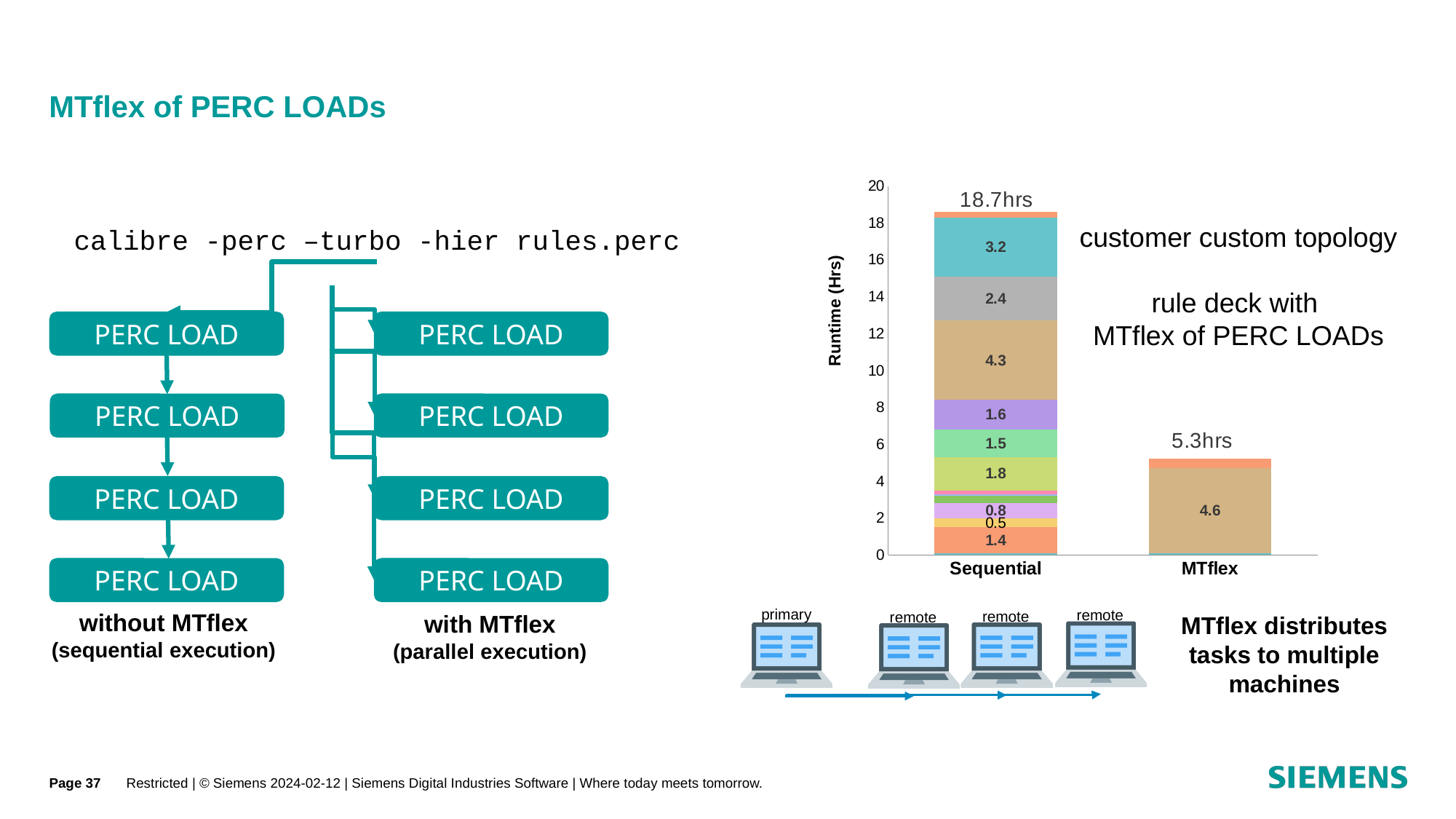
Is the total value for MTflex greater or less than 10? less What is the total runtime labeled above the MTflex bar? 5.3hrs What kind of chart is shown on the slide? Stacked bar chart What is the value of the largest labeled segment in the Sequential bar? 4.3 Which category has the lowest total runtime? MTflex How many categories are shown on the x axis of the chart? 2 What is the total runtime labeled above the Sequential bar? 18.7hrs What is the value of the large labeled segment in the MTflex bar? 4.6 Which category has the highest total runtime? Sequential What is the difference between the Sequential total and the MTflex total? 13.4hrs Which bar is taller, Sequential or MTflex? Sequential What is the title of the y axis of the chart? Runtime (Hrs)